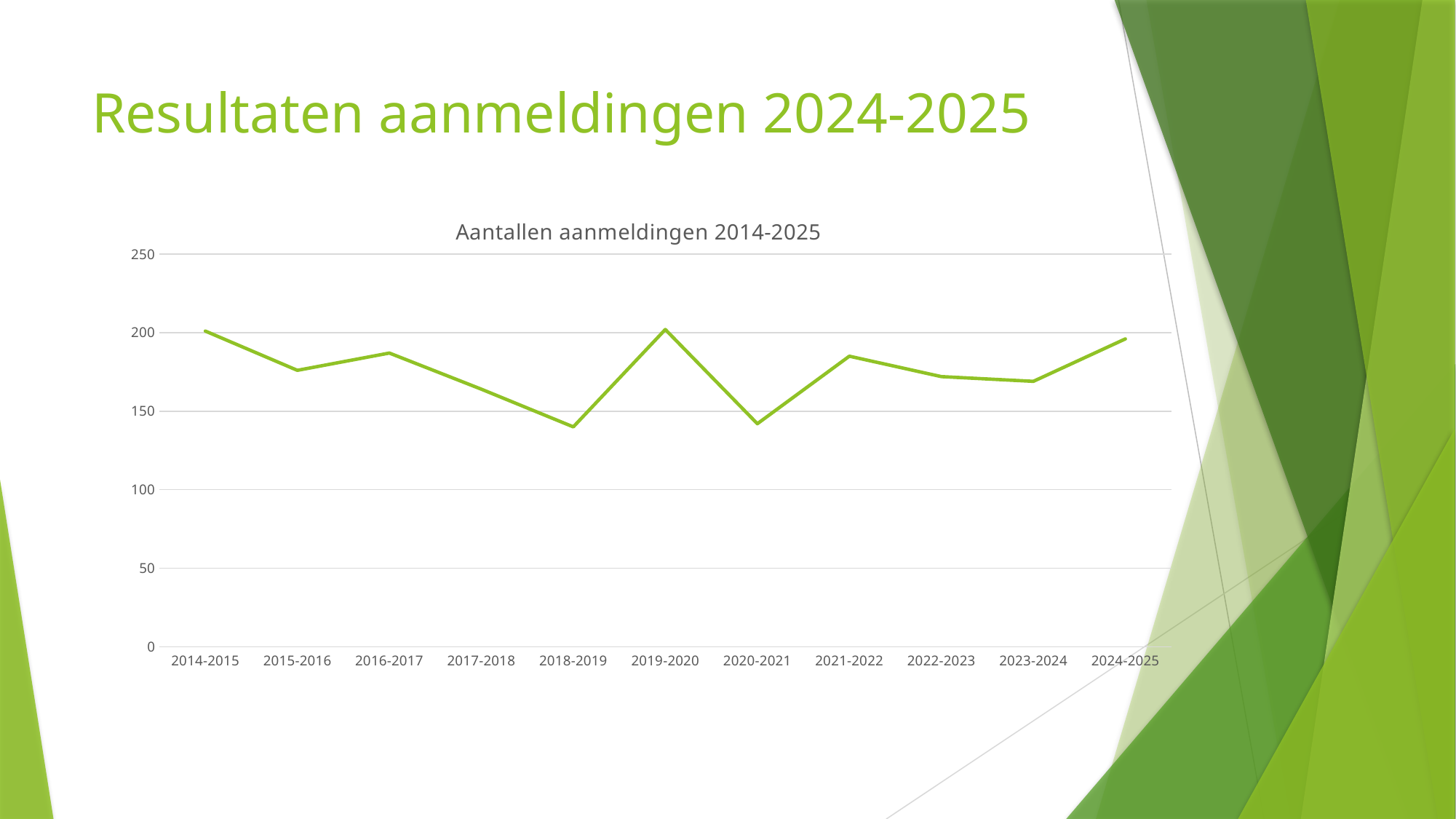
Is the value for 2015-2016 greater or less than 150? greater Which is larger, the value for 2017-2018 or the value for 2018-2019? 2017-2018 Is the value for 2018-2019 greater or less than 150? less What kind of chart is shown on the slide? line chart Between 2016-2017 and 2018-2019, do the values rise or fall? fall Which is larger, the value for 2016-2017 or the value for 2015-2016? 2016-2017 Which is larger, the value for 2024-2025 or the value for 2023-2024? 2024-2025 Is the value for 2020-2021 greater or less than 150? less How many school years are plotted on the x axis? 11 What is the title of the chart? Aantallen aanmeldingen 2014-2025